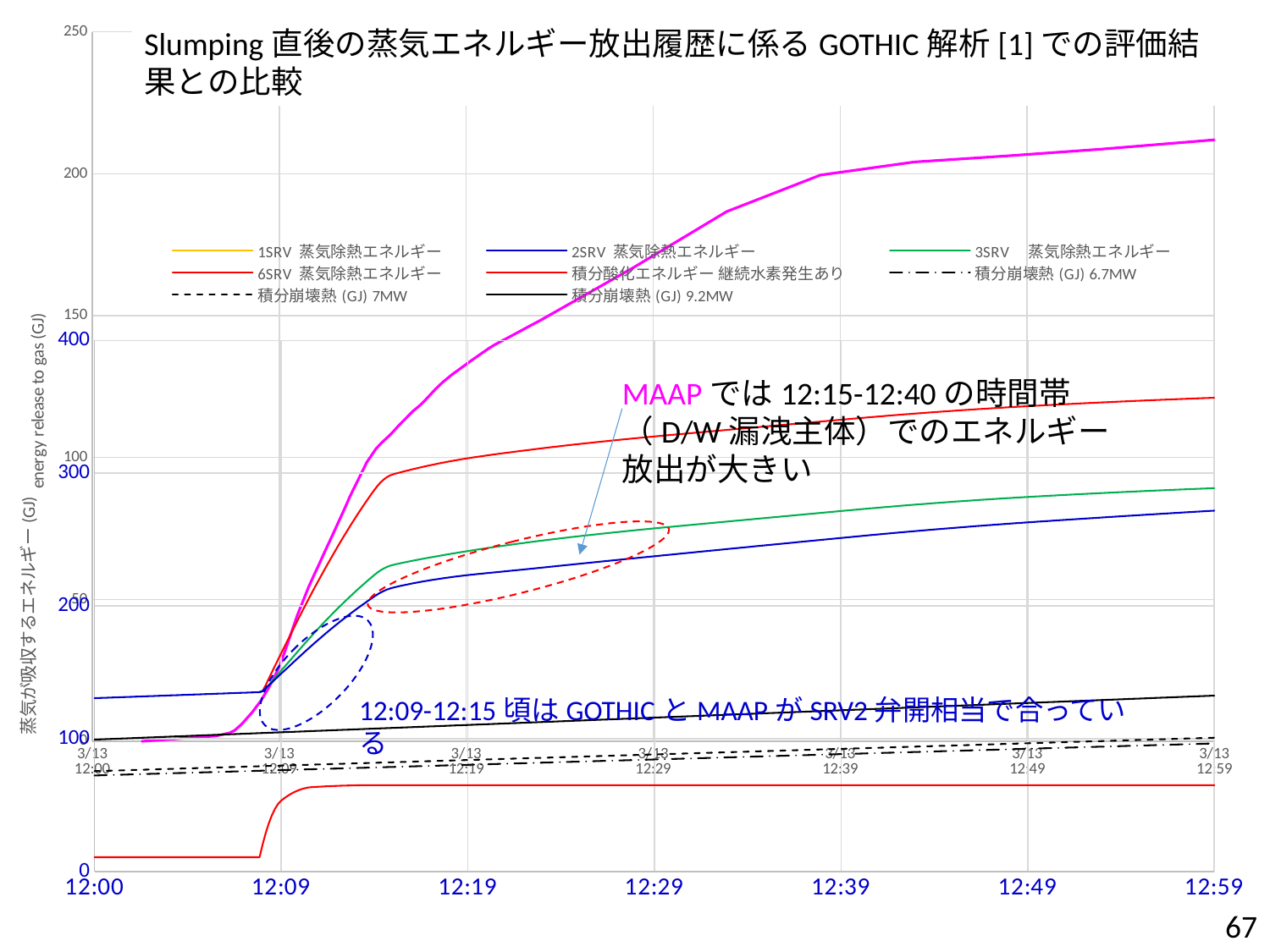
What colour is the 3SRV 蒸気除熱エネルギー line in the legend? green Does the lower red 積分酸化エネルギー line rise or stay flat between 12:19 and 12:59? stay flat On the gray left axis running from 0 to 250, is the magenta line at 12:29 greater or less than 150? greater At 12:59, is the red 6SRV 蒸気除熱エネルギー line higher or lower than the green 3SRV 蒸気除熱エネルギー line? higher How many series does the chart legend list? 8 On the gray left axis running from 0 to 250, is the magenta line at 12:59 greater or less than 200? greater How many time labels are shown along the blue x axis from 12:00 to 12:59? 7 At 12:59, is the green 3SRV 蒸気除熱エネルギー line higher or lower than the blue 2SRV 蒸気除熱エネルギー line? higher Which legend entry is drawn with a dash-dot black line? 積分崩壊熱 (GJ) 6.7MW Does the magenta line rise or fall from 12:09 to 12:59? rise What kind of chart is shown on the slide? line chart On the gray left axis running from 0 to 250, is the red 6SRV 蒸気除熱エネルギー line at 12:59 greater or less than 100? greater